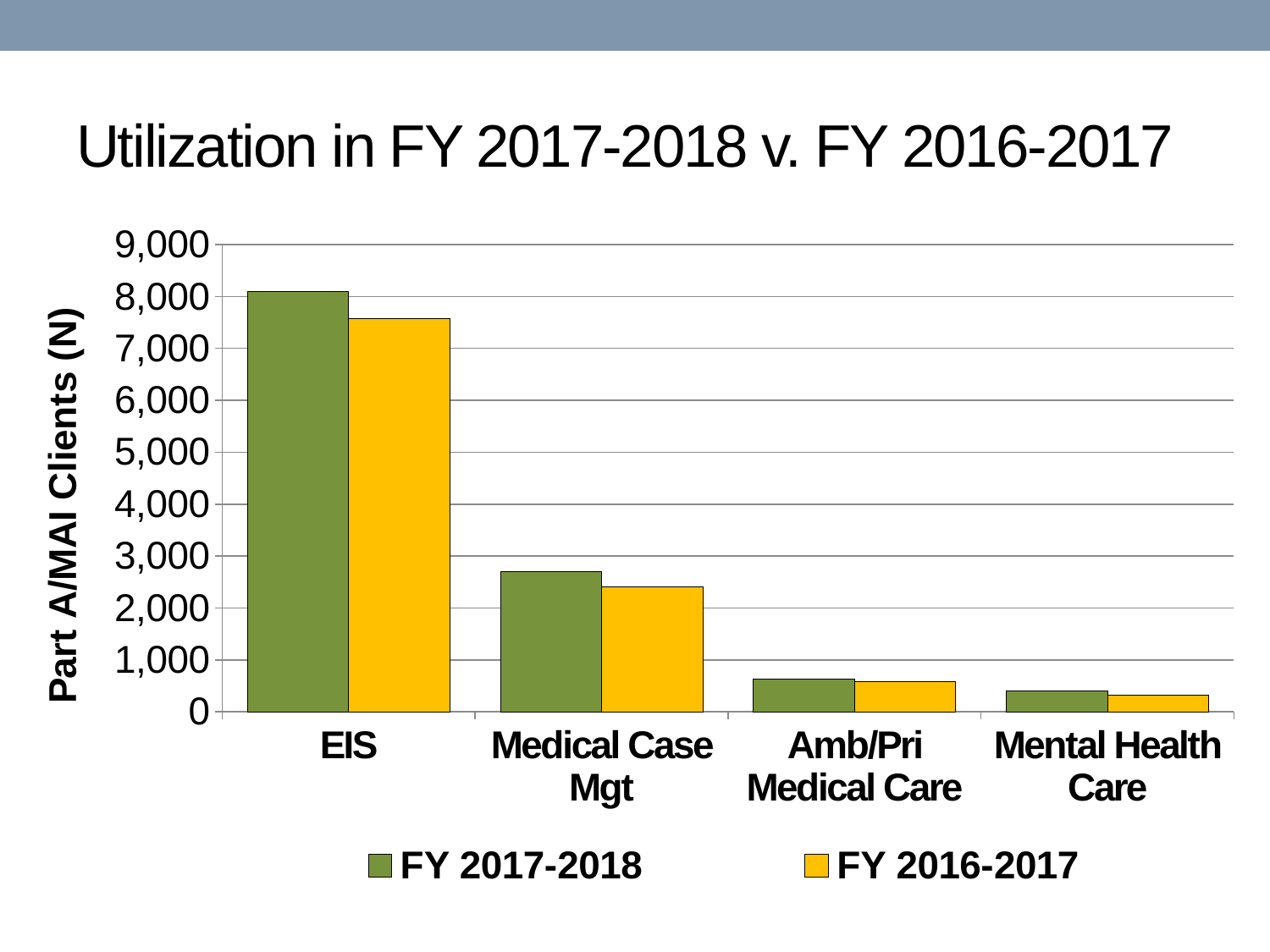
For Medical Case Mgt, which is larger: the FY 2017-2018 value or the FY 2016-2017 value? FY 2017-2018 Is the FY 2017-2018 value for EIS greater or less than 7,000? greater How many series does the legend list? 2 What is the label of the y axis? Part A/MAI Clients (N) What kind of chart is shown on the slide? bar chart Is the FY 2017-2018 value for Medical Case Mgt greater or less than 2,000? greater Is the FY 2016-2017 value for Amb/Pri Medical Care greater or less than 1,000? less For EIS, which is larger: the FY 2017-2018 value or the FY 2016-2017 value? FY 2017-2018 Which category has the highest value for FY 2017-2018? EIS How many categories are shown on the x axis? 4 Which category has the lowest value for FY 2016-2017? Mental Health Care